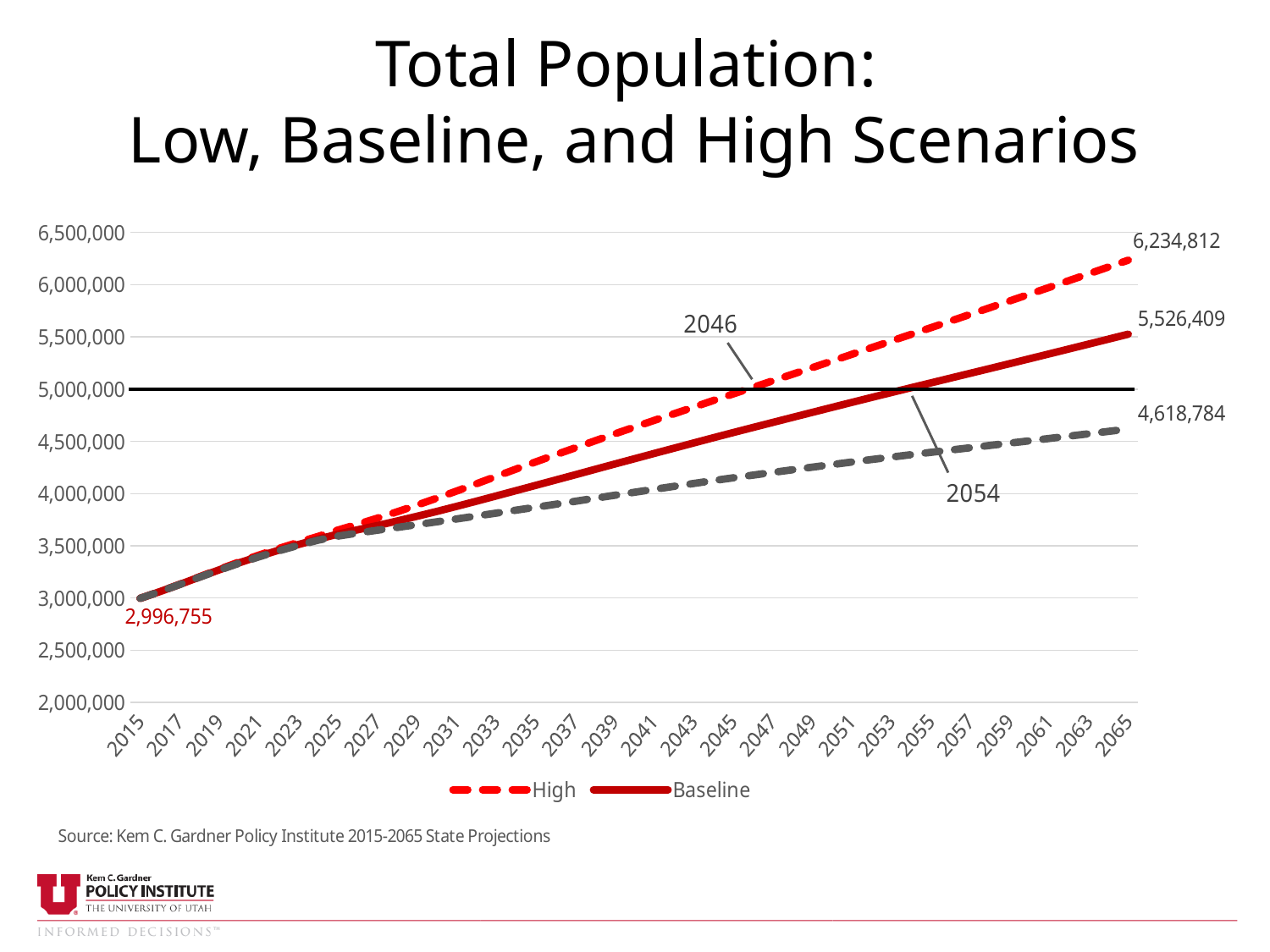
What is the difference between the High and Baseline values in 2065? 708,403 What is the 2065 value labelled for the Baseline scenario? 5,526,409 How many series does the legend list? 2 In which year does the Baseline scenario line cross the 5,000,000 line, according to the annotation? 2054 What is the 2065 value labelled for the lowest (gray dashed) line? 4,618,784 Which scenario has the highest value in 2065? High What is the 2065 value labelled for the High scenario? 6,234,812 What is the title of the chart? Total Population: Low, Baseline, and High Scenarios In which year does the High scenario line cross the 5,000,000 line, according to the annotation? 2046 What type of chart is shown on the slide? line chart Do the population values rise or fall from 2015 to 2065? rise What is the population value labelled at the start of the lines in 2015? 2,996,755